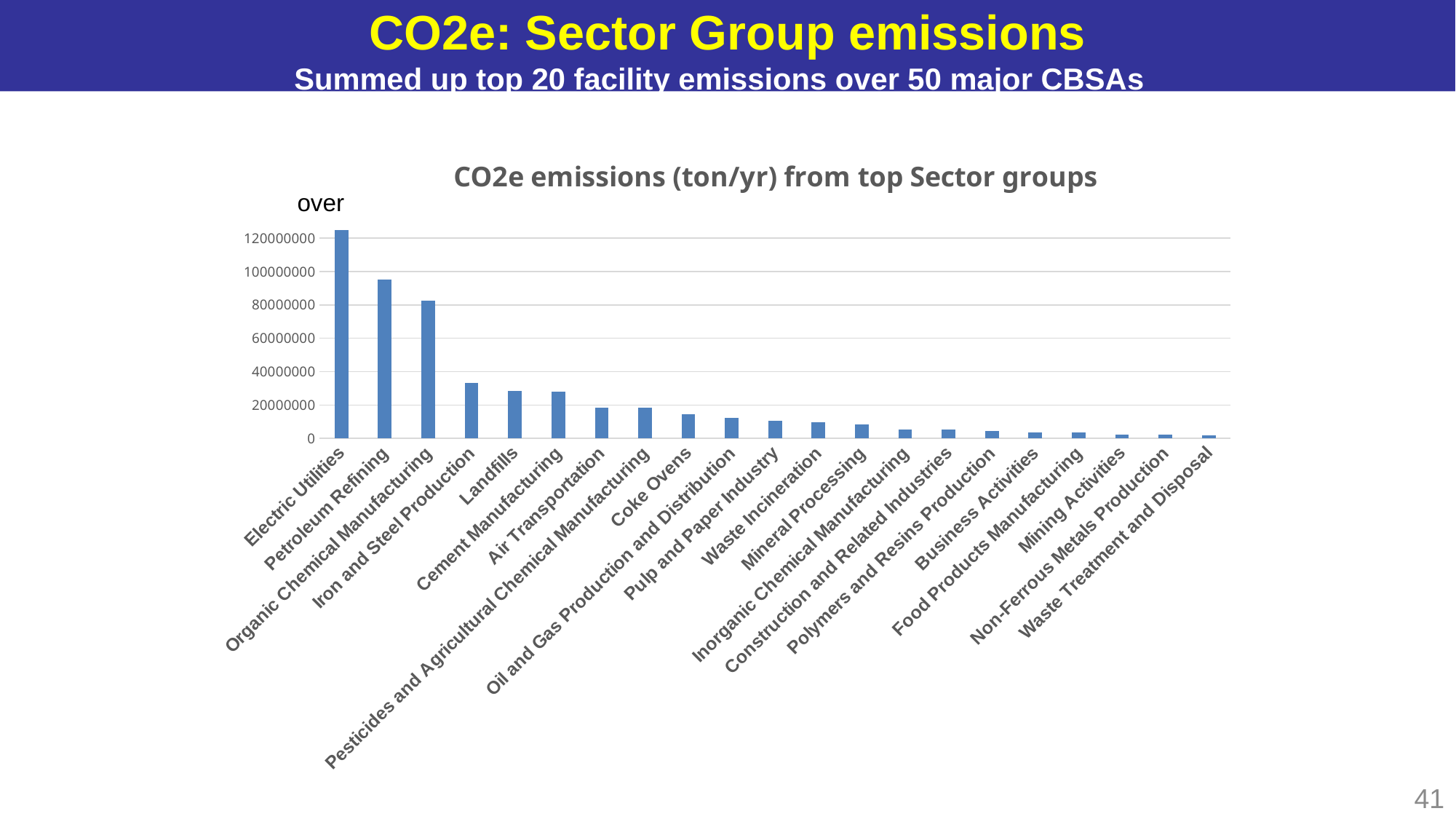
How many sector groups are plotted in the chart? 21 Is the value for Electric Utilities greater or less than 120000000? greater Is the value for Iron and Steel Production greater or less than 40000000? less What kind of chart is shown on the slide? bar chart Is the value for Organic Chemical Manufacturing greater or less than 100000000? less Which sector group has the lowest CO2e emissions? Waste Treatment and Disposal Do the bar values rise or fall moving from left to right along the x axis? fall What is the title of the chart? CO2e emissions (ton/yr) from top Sector groups Which has higher CO2e emissions, Petroleum Refining or Organic Chemical Manufacturing? Petroleum Refining Which sector group has the highest CO2e emissions? Electric Utilities